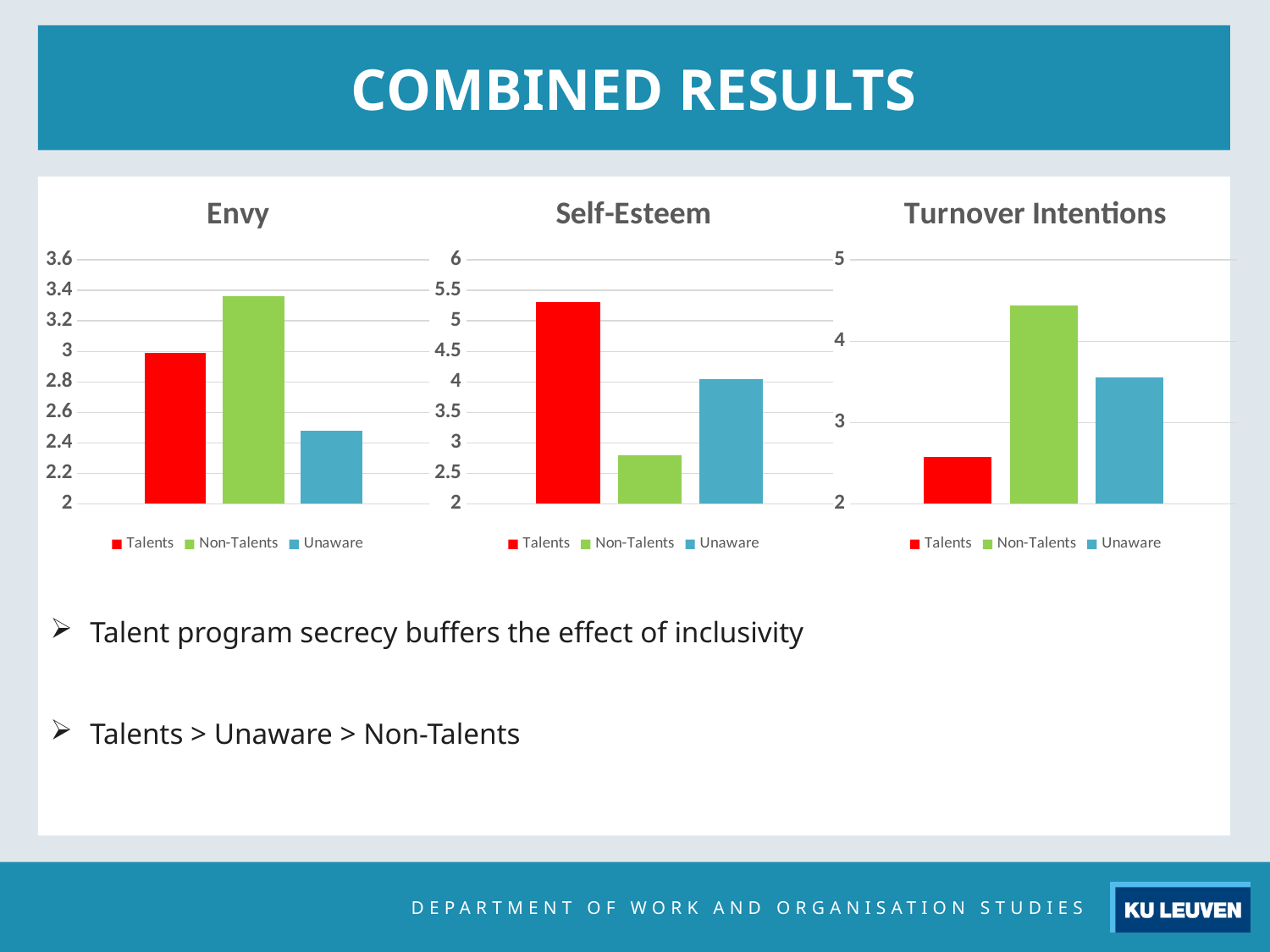
How many series does the legend of the Self-Esteem chart list? 3 In the Envy chart, which is larger, the value for Talents or the value for Unaware? Talents What kind of chart is the Turnover Intentions chart? Bar chart In the Turnover Intentions chart, is the value for Talents greater or less than 3? less In the Envy chart, which group has the highest value? Non-Talents In the Self-Esteem chart, which group has the lowest value? Non-Talents In the Self-Esteem chart, which group has the highest value? Talents In the Turnover Intentions chart, which group has the lowest value? Talents In the Self-Esteem chart, is the value for Talents greater or less than 5? greater In the Envy chart, which group has the lowest value? Unaware In the Turnover Intentions chart, which group has the highest value? Non-Talents In the Envy chart, is the value for Non-Talents greater or less than 3.2? greater